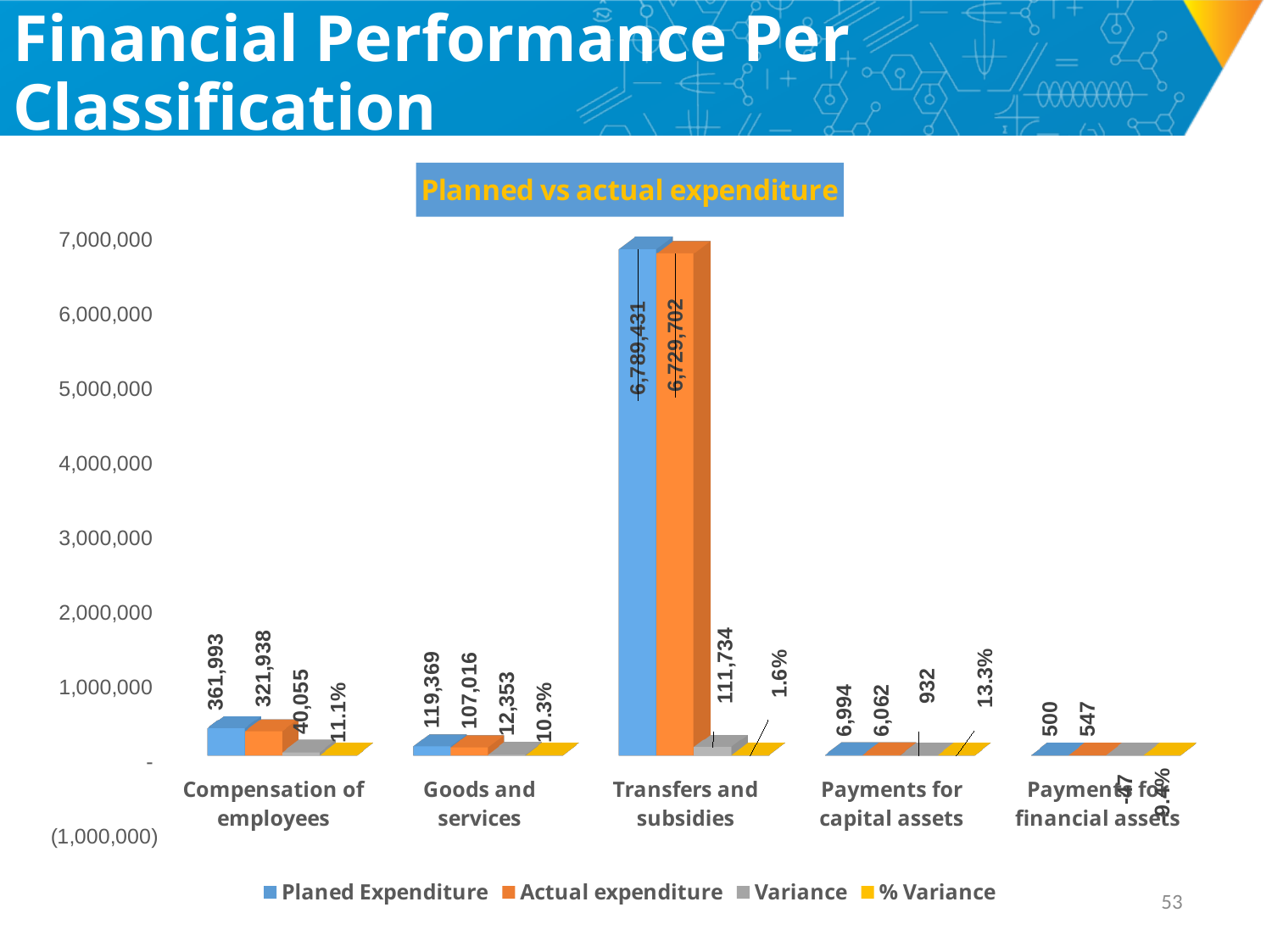
What is the Planed Expenditure value for Compensation of employees? 361,993 What is the % Variance value for Payments for capital assets? 13.3% What is the difference between Planed Expenditure and Actual expenditure for Compensation of employees? 40,055 What is the Actual expenditure value for Transfers and subsidies? 6,729,702 Which is larger for Goods and services: Planed Expenditure or Actual expenditure? Planed Expenditure Which category has the highest Planed Expenditure? Transfers and subsidies What is the Variance value for Goods and services? 12,353 What is the Actual expenditure value for Payments for financial assets? 547 What type of chart is shown on the slide? Bar chart How many categories are shown on the x axis? 5 How many series does the legend list? 4 Which category has the lowest Planed Expenditure? Payments for financial assets